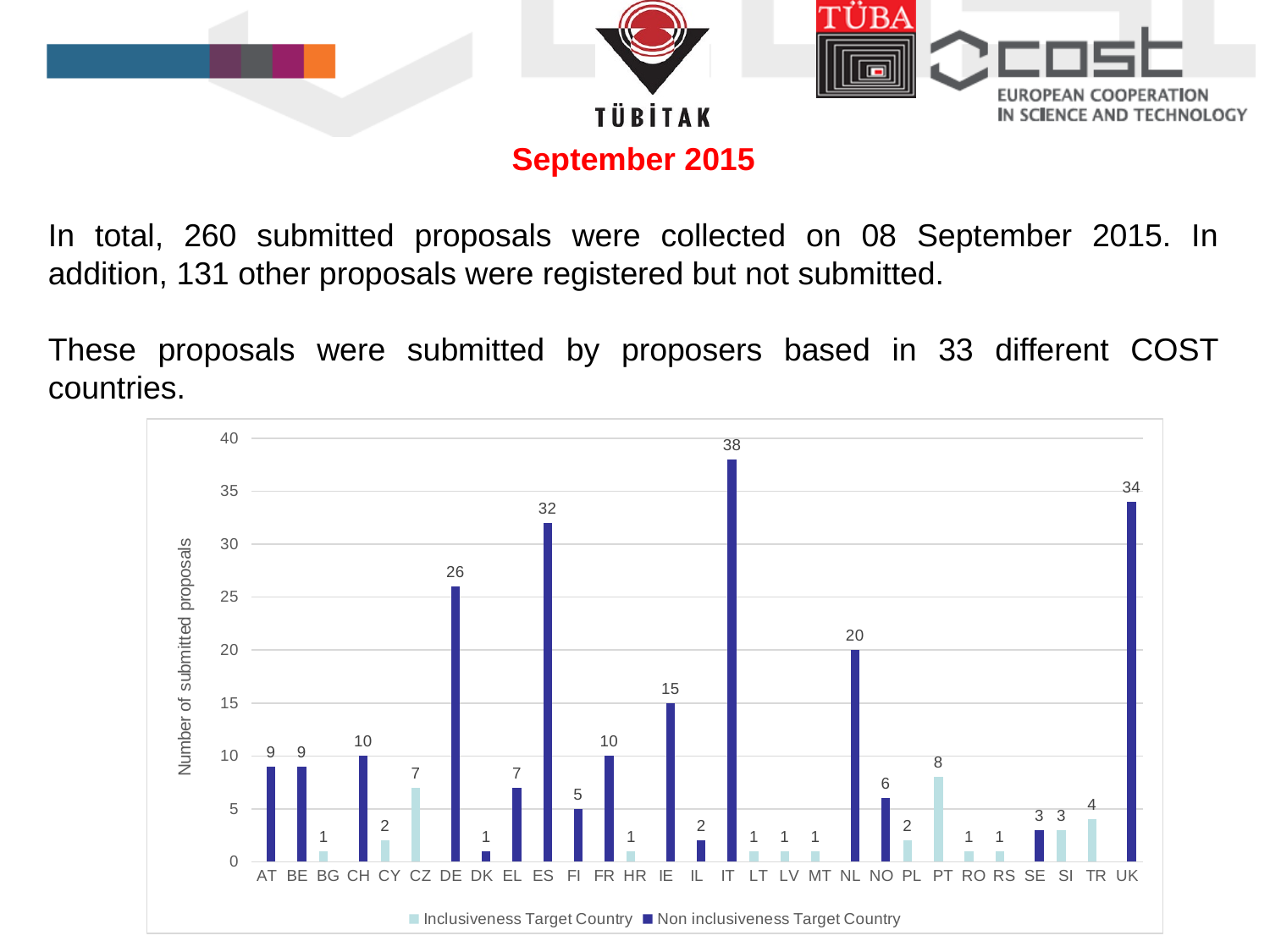
What is the number of submitted proposals for DE? 26 What kind of chart is shown on the slide? Bar chart Which country has the highest number of submitted proposals? IT How many countries are shown on the x axis of the chart? 29 What is the difference between the number of submitted proposals for IT and UK? 4 Which has more submitted proposals, NL or IE? NL What is the number of submitted proposals for PT? 8 How many series does the legend list? 2 What is the difference between the number of submitted proposals for UK and ES? 2 What is the number of submitted proposals for IT? 38 What is the title of the y axis of the chart? Number of submitted proposals What is the number of submitted proposals for CZ? 7